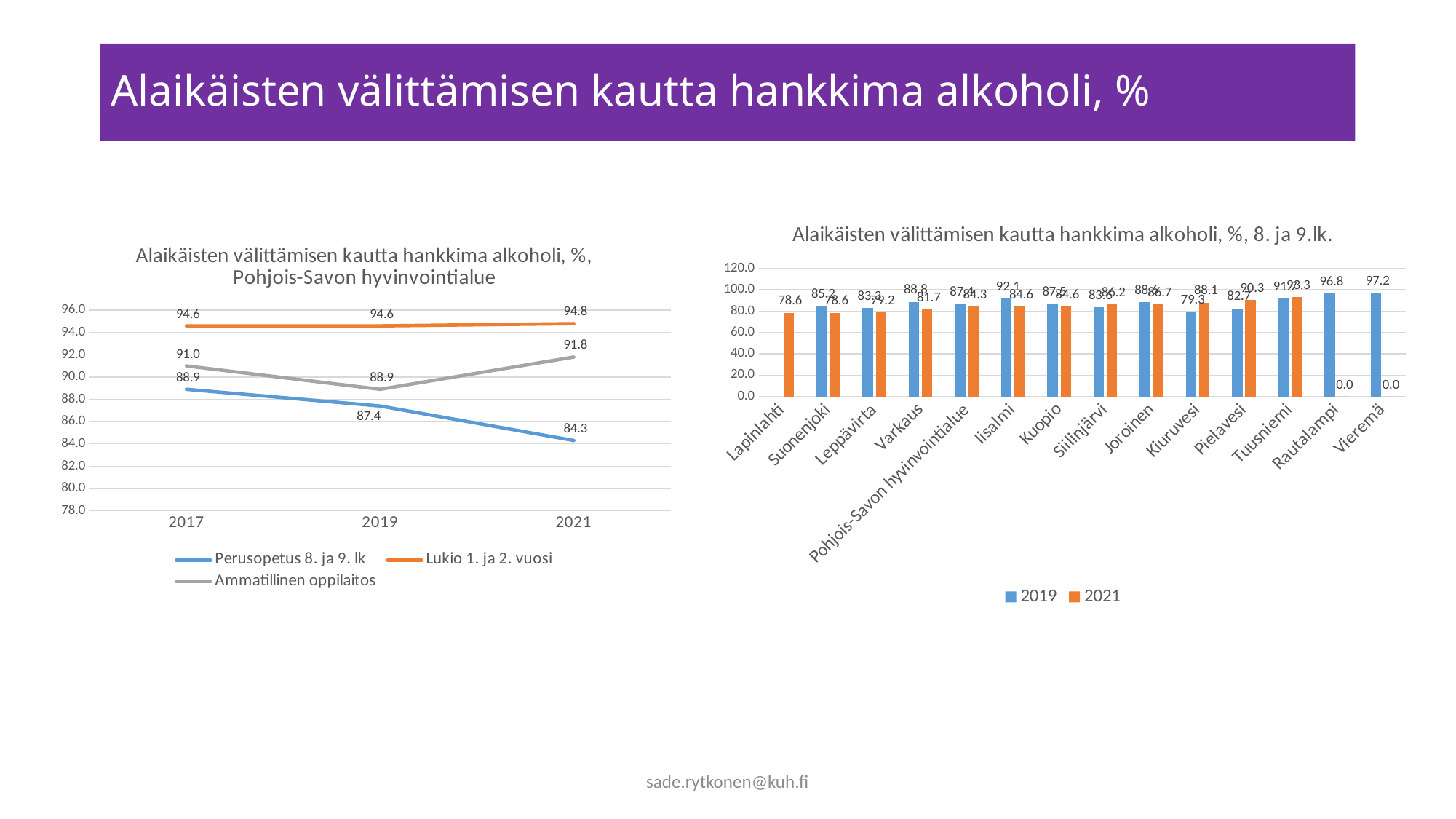
In the left line chart (Pohjois-Savon hyvinvointialue), how many series does the legend list? 3 In the right bar chart (8. ja 9.lk.), what is the 2019 value for Iisalmi? 92.1 In the left line chart (Pohjois-Savon hyvinvointialue), what is the value for Lukio 1. ja 2. vuosi in 2017? 94.6 In the left line chart (Pohjois-Savon hyvinvointialue), does the Perusopetus 8. ja 9. lk line rise or fall from 2017 to 2021? fall In the right bar chart (8. ja 9.lk.), which category has the highest 2019 value? Vieremä In the left line chart (Pohjois-Savon hyvinvointialue), what is the difference between the Lukio 1. ja 2. vuosi value and the Perusopetus 8. ja 9. lk value in 2021? 10.5 In the right bar chart (8. ja 9.lk.), what is the 2021 value for Pielavesi? 90.3 In the left line chart (Pohjois-Savon hyvinvointialue), what is the value for Perusopetus 8. ja 9. lk in 2021? 84.3 In the right bar chart (8. ja 9.lk.), how many categories are shown on the x axis? 14 In the left line chart (Pohjois-Savon hyvinvointialue), what is the value for Ammatillinen oppilaitos in 2019? 88.9 What kind of chart is the right chart titled 'Alaikäisten välittämisen kautta hankkima alkoholi, %, 8. ja 9.lk.'? bar chart In the right bar chart (8. ja 9.lk.), which is larger for Kiuruvesi, the 2019 value or the 2021 value? 2021